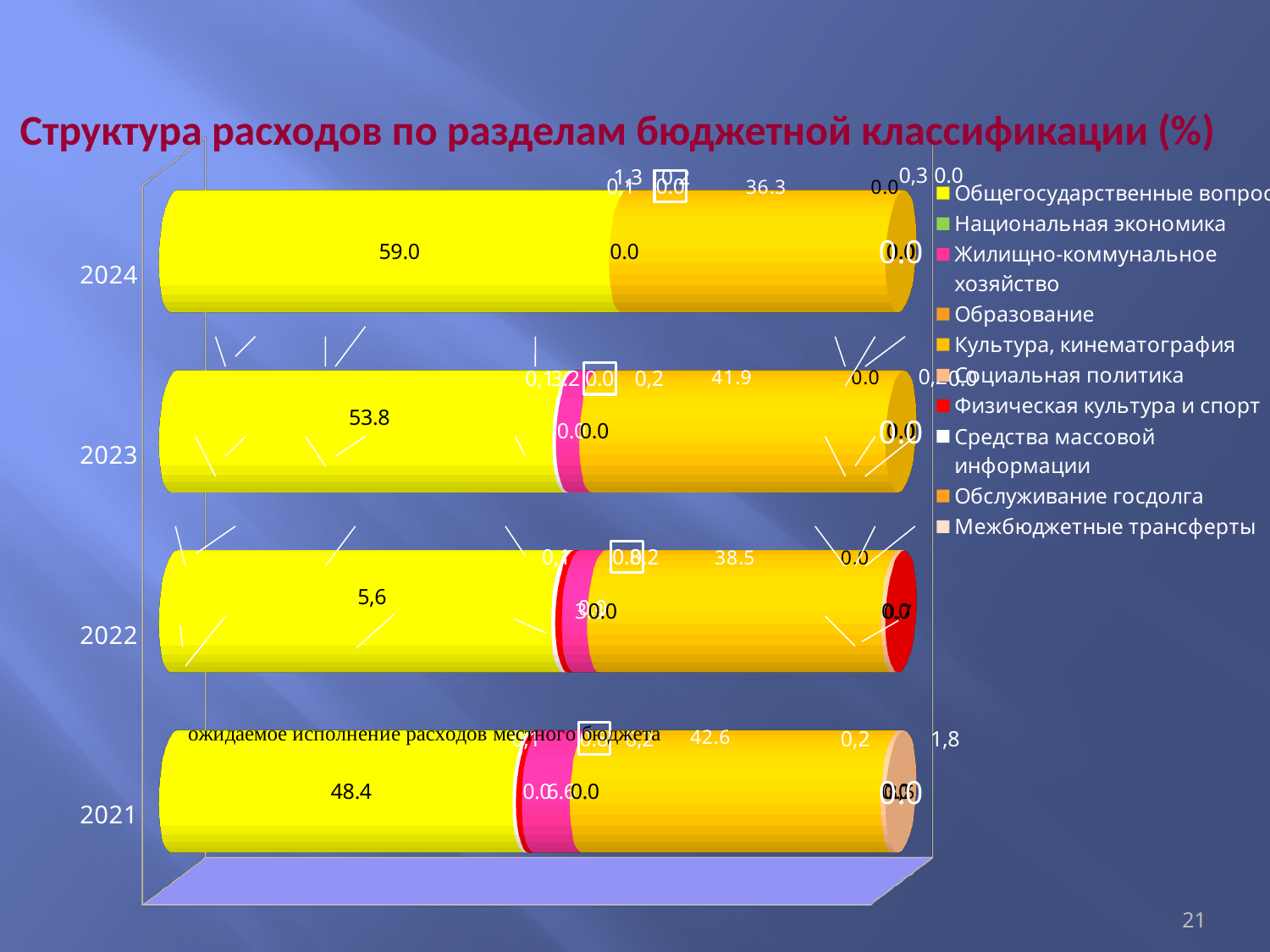
In which year is the yellow segment (Общегосударственные вопросы) the largest? 2024 How many series does the chart legend list? 10 What is the value labeled on the large orange segment of the 2021 bar? 42.6 What is the value labeled on the yellow segment (Общегосударственные вопросы) of the 2021 bar? 48.4 What is the title of the chart? Структура расходов по разделам бюджетной классификации (%) What is the difference between the yellow segment values for 2024 and 2023? 5.2 What kind of chart is shown on the slide? Stacked bar chart How many years (categories) are shown on the vertical axis of the chart? 4 Which year has the larger yellow segment (Общегосударственные вопросы) value, 2024 or 2021? 2024 What is the value labeled on the yellow segment (Общегосударственные вопросы) of the 2023 bar? 53.8 What is the value labeled on the large orange segment of the 2024 bar? 36.3 What is the value labeled on the yellow segment (Общегосударственные вопросы) of the 2024 bar? 59.0